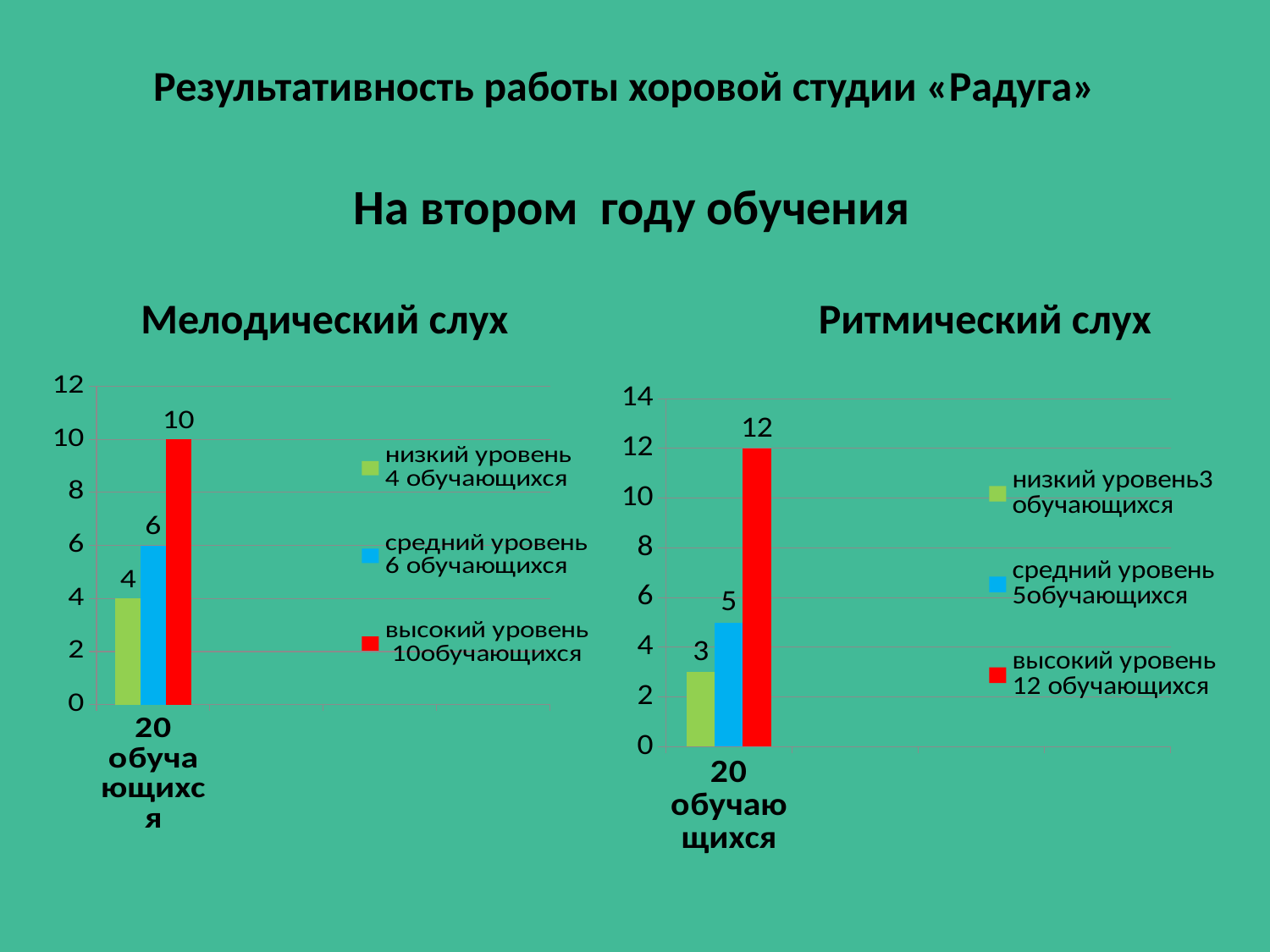
In the «Мелодический слух» chart, what is the value for «низкий уровень»? 4 In the «Мелодический слух» chart, what is the difference between the «высокий уровень» and «средний уровень» values? 4 In the «Ритмический слух» chart, what is the difference between the «высокий уровень» and «низкий уровень» values? 9 How many series does the legend of the «Ритмический слух» chart list? 3 In the «Ритмический слух» chart, which series has the lowest value? низкий уровень In the «Мелодический слух» chart, which series has the highest value? высокий уровень Which is larger: «средний уровень» in the «Мелодический слух» chart or «средний уровень» in the «Ритмический слух» chart? Мелодический слух What kind of chart is the «Мелодический слух» chart? bar chart In the «Ритмический слух» chart, what colour is the bar for «высокий уровень»? red In the «Ритмический слух» chart, what is the value for «средний уровень»? 5 In the «Ритмический слух» chart, what is the value for «высокий уровень»? 12 In the «Мелодический слух» chart, what is the value for «высокий уровень»? 10